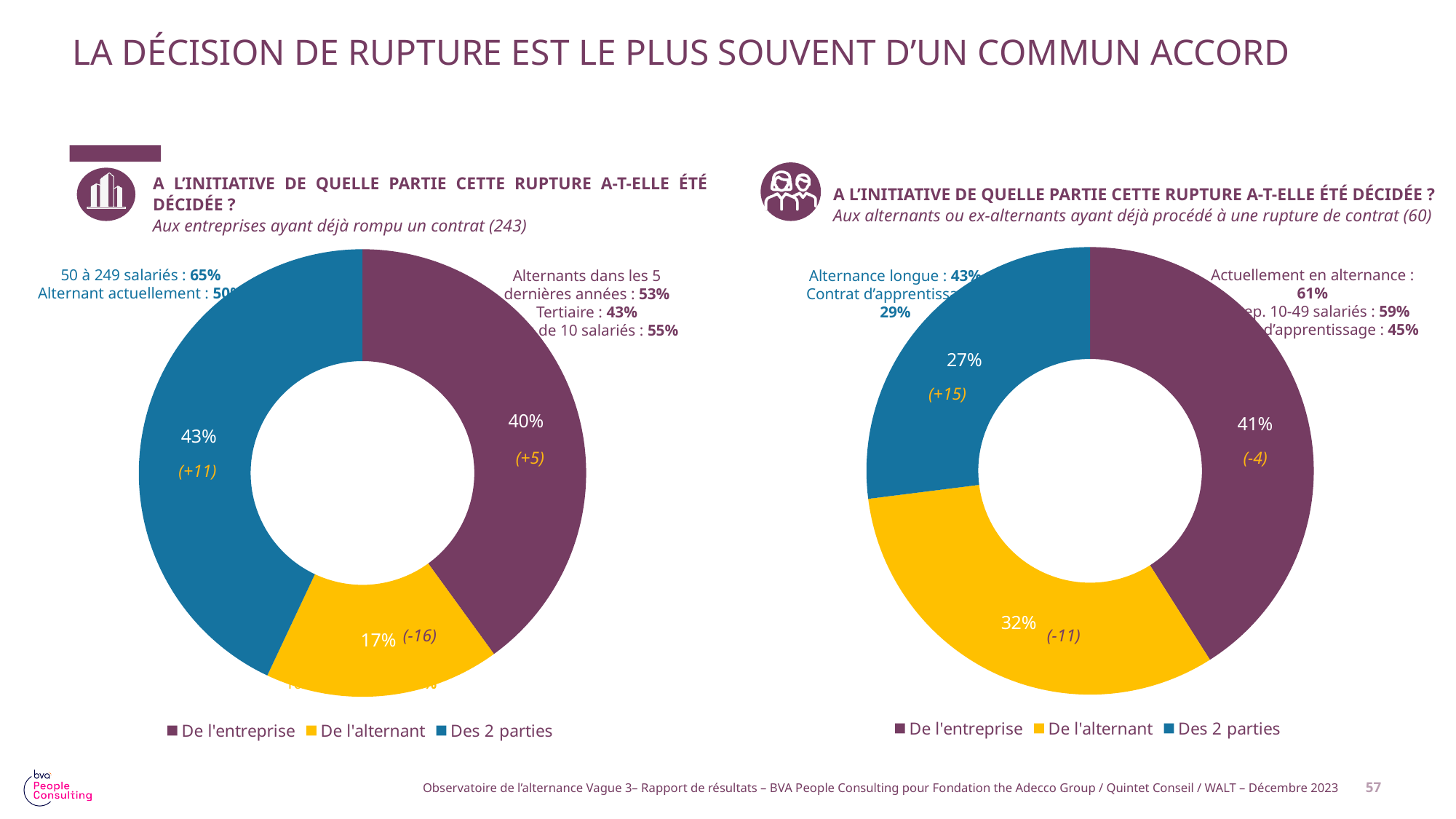
How many categories does the legend of the left chart list? 3 On the left chart (companies), what share of terminations were decided 'De l'alternant'? 17% On the right chart (alternants), which is larger: the share for 'De l'alternant' or the share for 'Des 2 parties'? De l'alternant What type of chart is used on the left side of the slide? Donut (pie) chart On the left chart (companies that have already terminated a contract), what share of terminations were decided by 'Des 2 parties'? 43% On the right chart (alternants), which category has the largest share? De l'entreprise On the right chart (alternants), which category has the smallest share? Des 2 parties On the left chart (companies), which category has the smallest share? De l'alternant On the left chart (companies), what change versus the previous wave is shown next to the 'De l'alternant' share? -16 On the left chart (companies), what is the difference between the 'Des 2 parties' share and the 'De l'alternant' share? 26 points On the right chart (alternants or ex-alternants), what share of terminations were decided 'De l'entreprise'? 41% On the right chart (alternants), what share of terminations were decided 'De l'alternant'? 32%